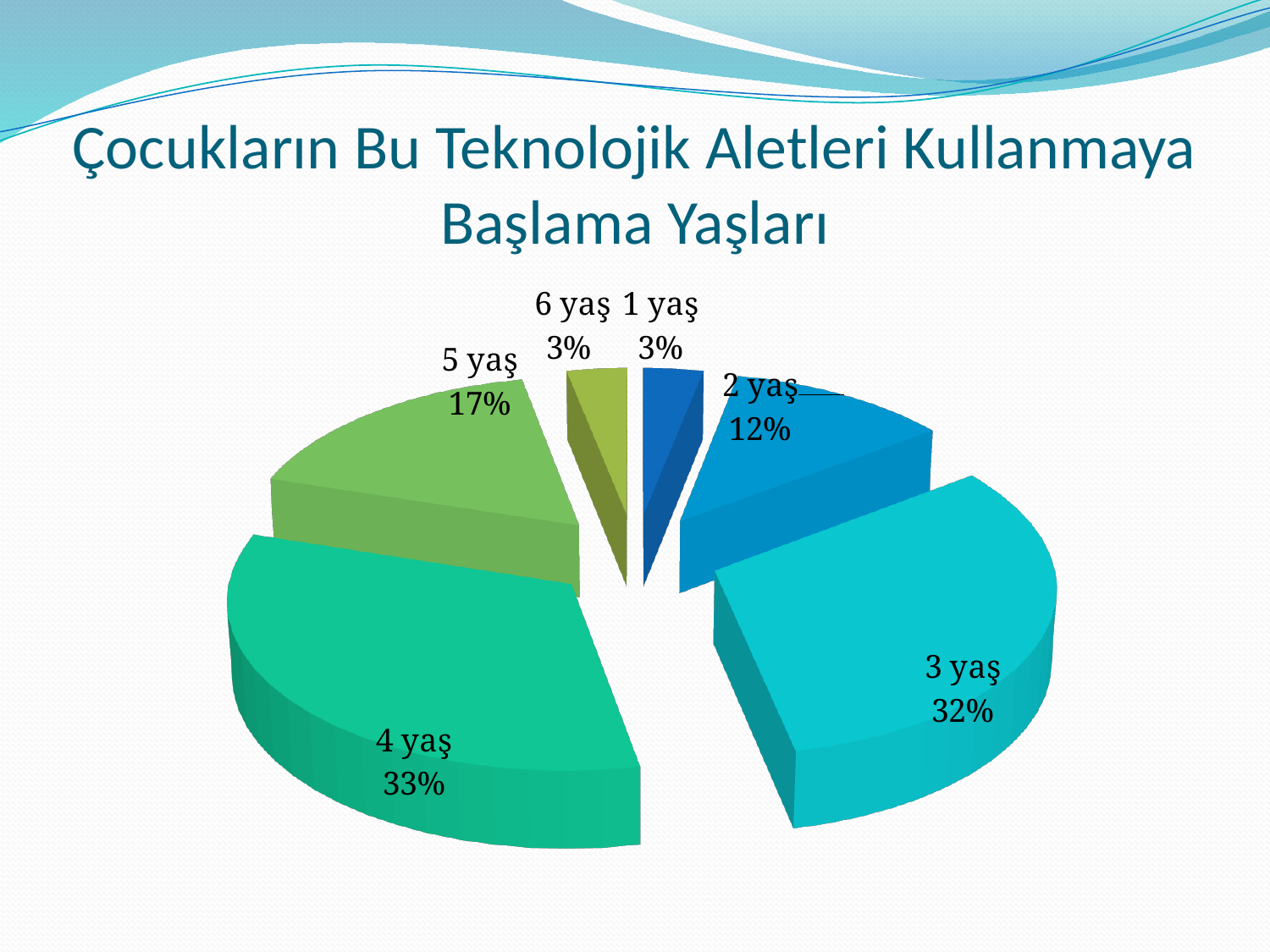
What percentage of the pie is labelled 1 yaş? 3% What percentage of the pie is labelled 2 yaş? 12% What is the title of the chart on the slide? Çocukların Bu Teknolojik Aletleri Kullanmaya Başlama Yaşları What kind of chart is shown on the slide? pie chart Which slice is larger, 5 yaş or 2 yaş? 5 yaş What percentage of the pie is labelled 3 yaş? 32% Which age category has the largest share of the pie? 4 yaş What percentage of the pie is labelled 4 yaş? 33% What is the difference in percentage points between the 5 yaş slice and the 2 yaş slice? 5 What percentage of the pie is labelled 5 yaş? 17% What percentage of the pie is labelled 6 yaş? 3% How many slices does the pie chart have? 6